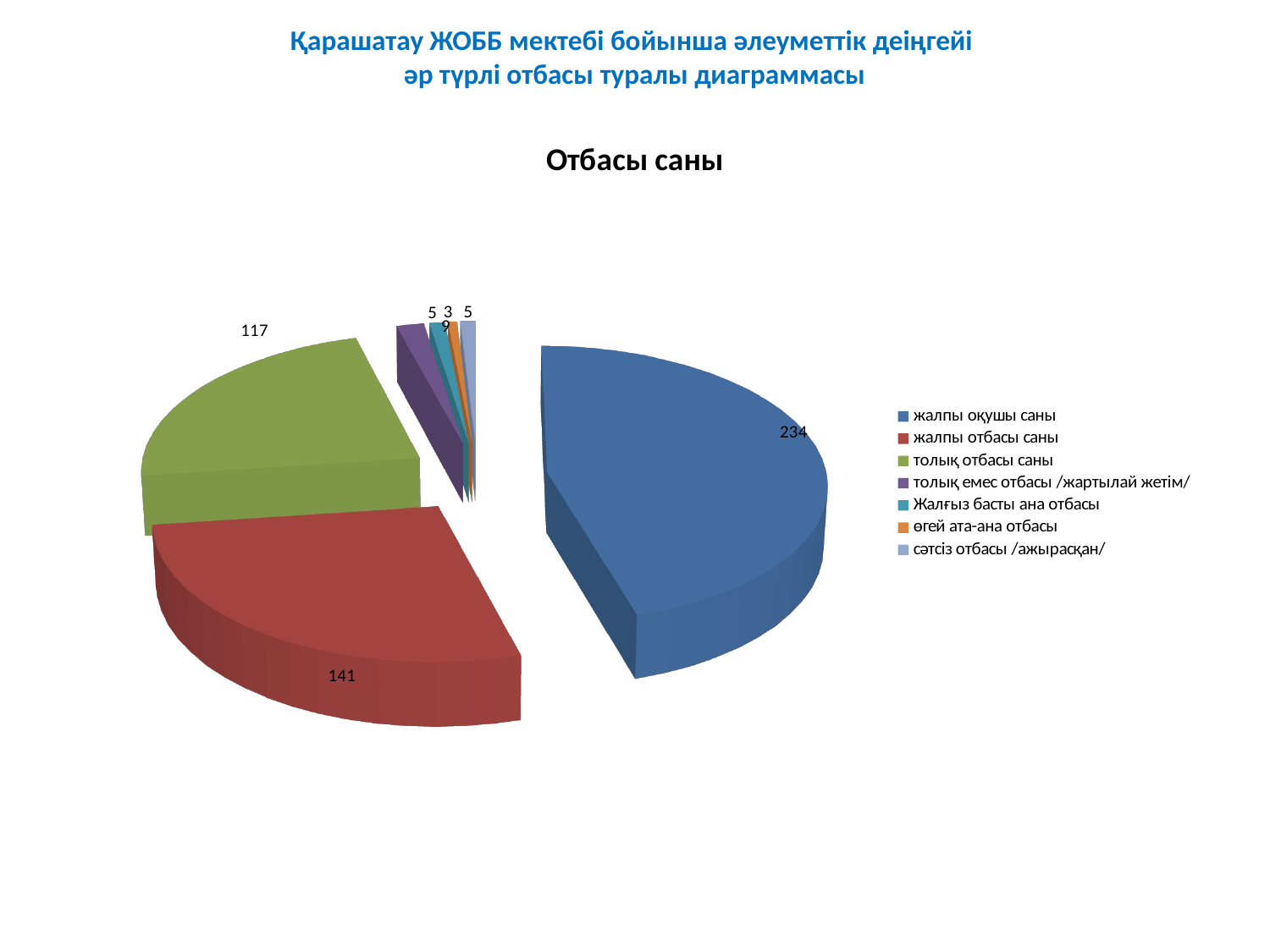
What is the value for толық отбасы саны? 117 Which is larger, толық отбасы саны or жалпы отбасы саны? жалпы отбасы саны What is the value for жалпы отбасы саны? 141 What is the difference between жалпы оқушы саны and жалпы отбасы саны? 93 Is the value for толық отбасы саны greater or less than 100? greater How many categories does the legend list? 7 What type of chart is shown on the slide? pie chart What is the title of the chart? Отбасы саны What is the difference between жалпы отбасы саны and толық отбасы саны? 24 What is the value for жалпы оқушы саны? 234 What colour is the slice for жалпы оқушы саны? blue Which category has the largest slice of the pie? жалпы оқушы саны